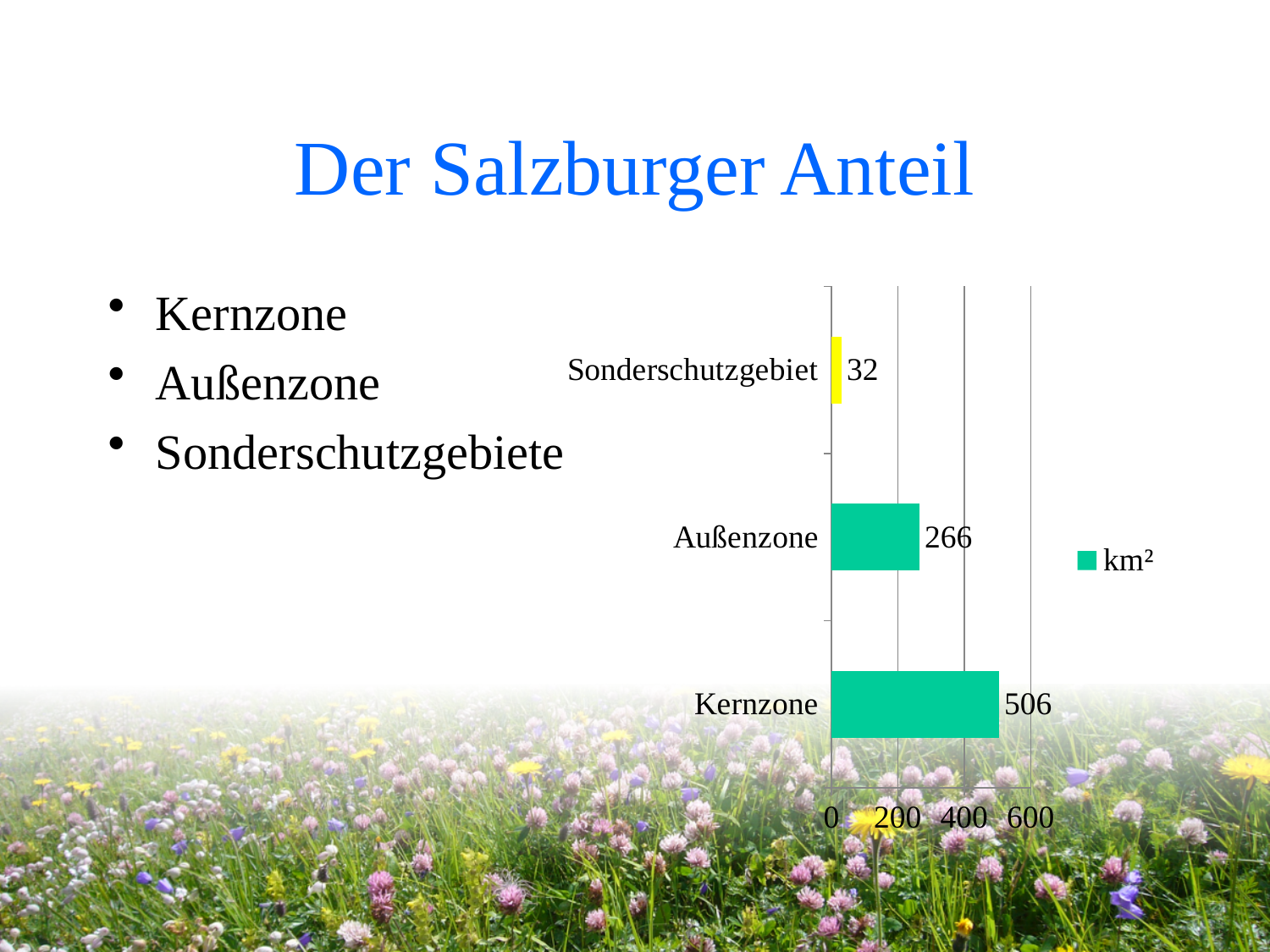
What is the value for Außenzone? 266 Which category has the highest value? Kernzone What is the difference between the values for Kernzone and Außenzone? 240 What is the difference between the values for Außenzone and Sonderschutzgebiet? 234 How many categories are shown in the chart? 3 What is the value for Sonderschutzgebiet? 32 Is the value for Kernzone greater or less than 400? greater Which category has the lowest value? Sonderschutzgebiet Which is larger, the value for Außenzone or the value for Sonderschutzgebiet? Außenzone What series name does the legend show? km² What is the value for Kernzone? 506 What kind of chart is shown on the slide? bar chart